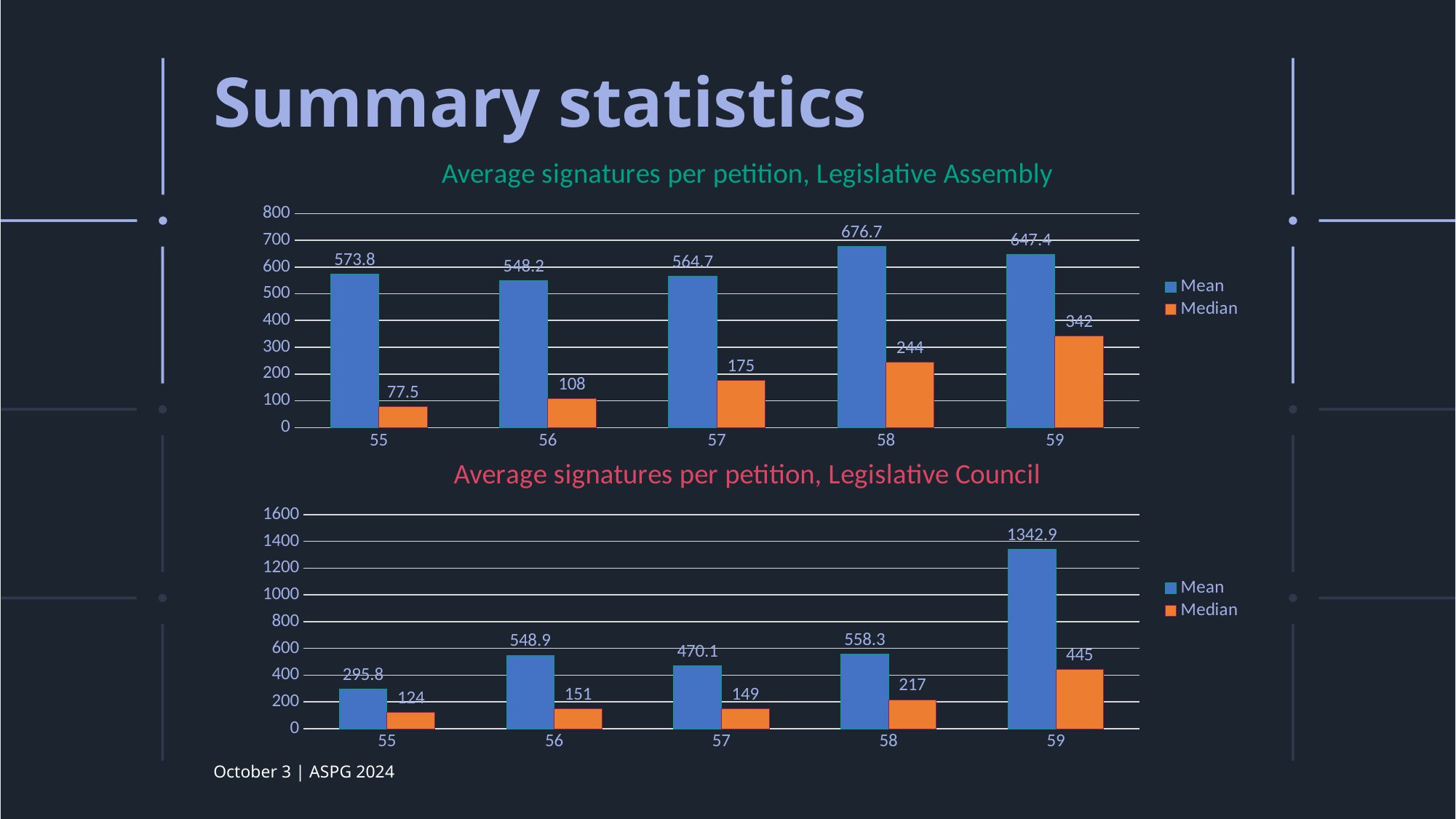
In the 'Average signatures per petition, Legislative Assembly' chart, which category has the lowest Mean value? 56 In the 'Average signatures per petition, Legislative Council' chart, what is the Median value for 58? 217 What kind of chart is the 'Average signatures per petition, Legislative Council' chart? Bar chart In the 'Average signatures per petition, Legislative Council' chart, what is the Mean value for 59? 1342.9 In the 'Average signatures per petition, Legislative Council' chart, which category has the lowest Mean value? 55 In the 'Average signatures per petition, Legislative Assembly' chart, how many series does the legend list? 2 In the 'Average signatures per petition, Legislative Assembly' chart, what is the difference between the Mean and Median values for 59? 305.4 In the 'Average signatures per petition, Legislative Council' chart, is the Mean value for 56 larger than the Mean value for 57? Yes In the 'Average signatures per petition, Legislative Council' chart, which category has the highest Median value? 59 In the 'Average signatures per petition, Legislative Council' chart, how many categories are shown on the x axis? 5 In the 'Average signatures per petition, Legislative Assembly' chart, what is the Median value for 55? 77.5 In the 'Average signatures per petition, Legislative Assembly' chart, what is the Mean value for 58? 676.7